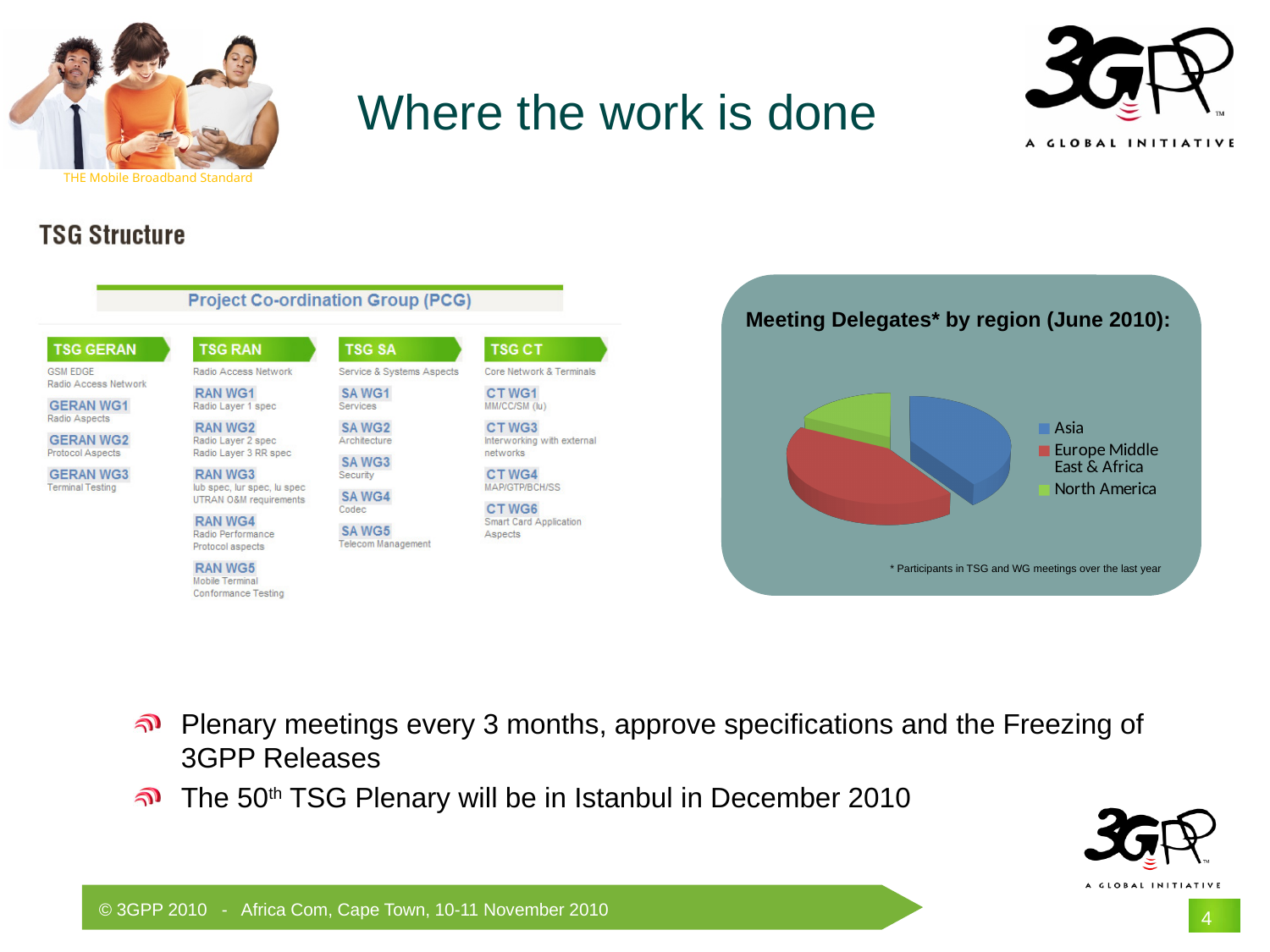
Which slice is larger in the pie chart, Asia or North America? Asia Which region has the largest slice of the pie chart? Europe Middle East & Africa Which slice is larger in the pie chart, Europe Middle East & Africa or Asia? Europe Middle East & Africa Which region has the smallest slice of the pie chart? North America Which region is shown in red in the pie chart? Europe Middle East & Africa Which region is shown in green in the pie chart? North America What colour represents Asia in the pie chart? blue How many regions (slices) does the pie chart show? 3 What is the title of the pie chart? Meeting Delegates* by region (June 2010): What kind of chart is shown on the slide? pie chart